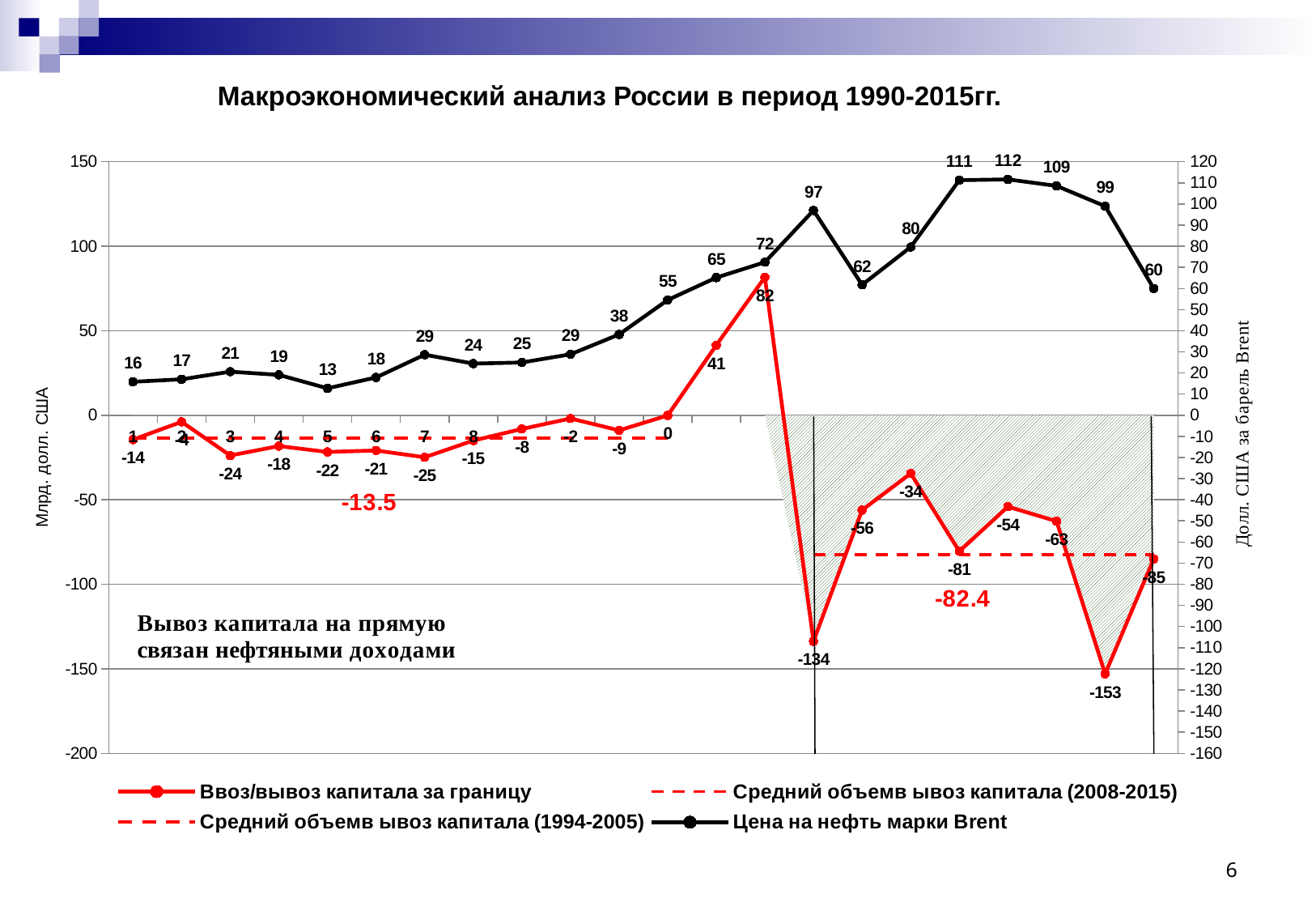
How many series does the legend list? 4 What is the Brent oil price value at x-axis category 7? 29 How many data points does the Brent oil price series have? 22 What is the highest value of the capital flow series (Ввоз/вывоз капитала за границу)? 82 What kind of chart is shown on the slide? line chart What is the difference between the highest Brent price (112) and the last Brent price (60)? 52 What is the average capital outflow for 2008-2015 shown on the chart? -82.4 What is the capital flow value at x-axis category 3? -24 What is the lowest value of the capital flow series (Ввоз/вывоз капитала за границу)? -153 What is the lowest value of the Brent oil price series? 13 What is the average capital outflow for 1994-2005 shown on the chart? -13.5 What is the highest value of the Brent oil price series (Цена на нефть марки Brent)? 112